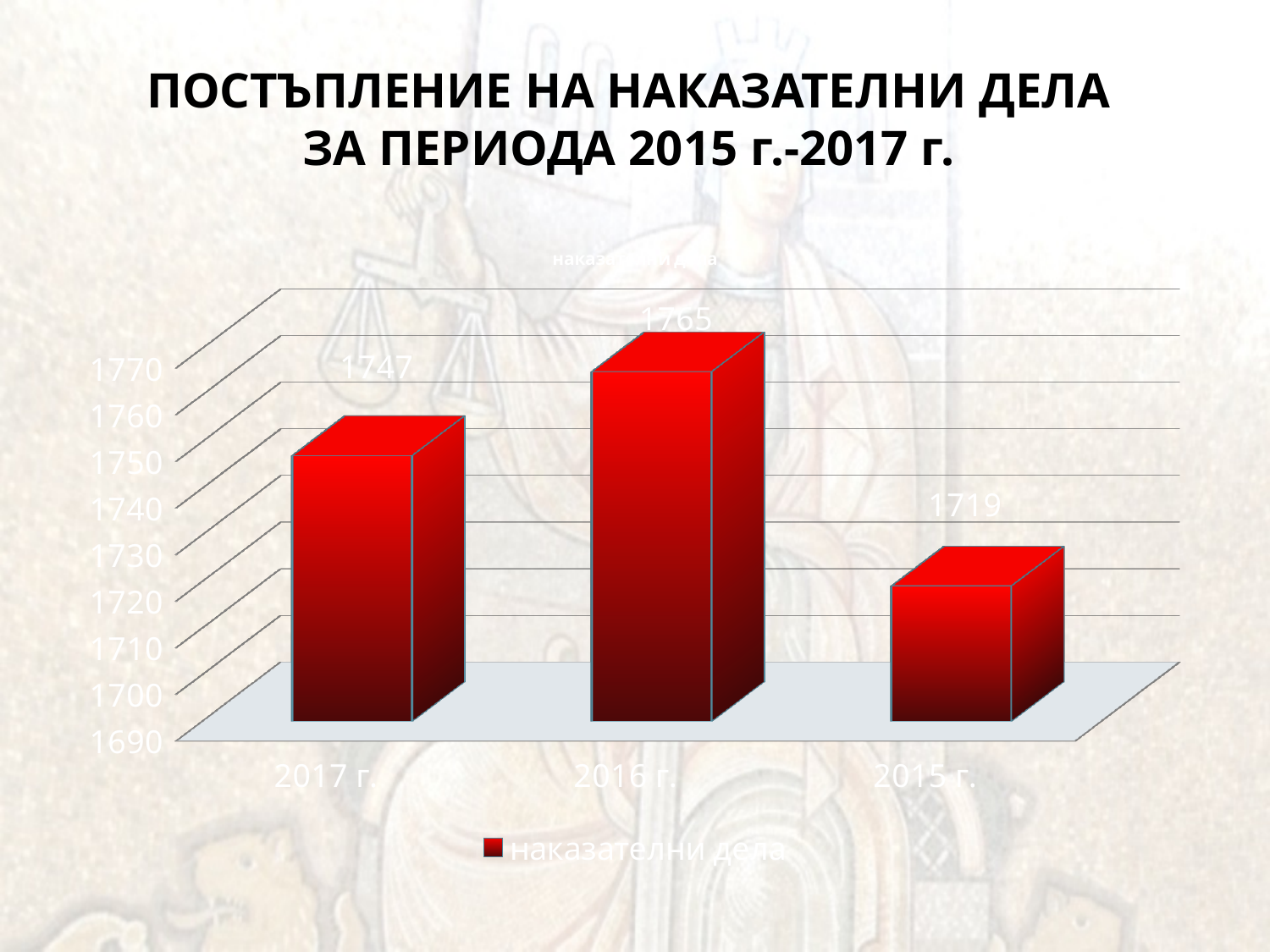
What is the difference between the values for 2017 г. and 2015 г.? 28 Which year has the lowest value? 2015 г. What series name does the legend show? наказателни дела Is the value for 2015 г. greater or less than 1730? less What kind of chart is shown on the slide? bar chart How many categories are shown on the x axis? 3 Which year has the highest value? 2016 г. What is the difference between the values for 2016 г. and 2015 г.? 46 What is the value for 2015 г.? 1719 What is the value for 2016 г.? 1765 What is the value for 2017 г.? 1747 Which is larger, the value for 2017 г. or the value for 2016 г.? 2016 г.